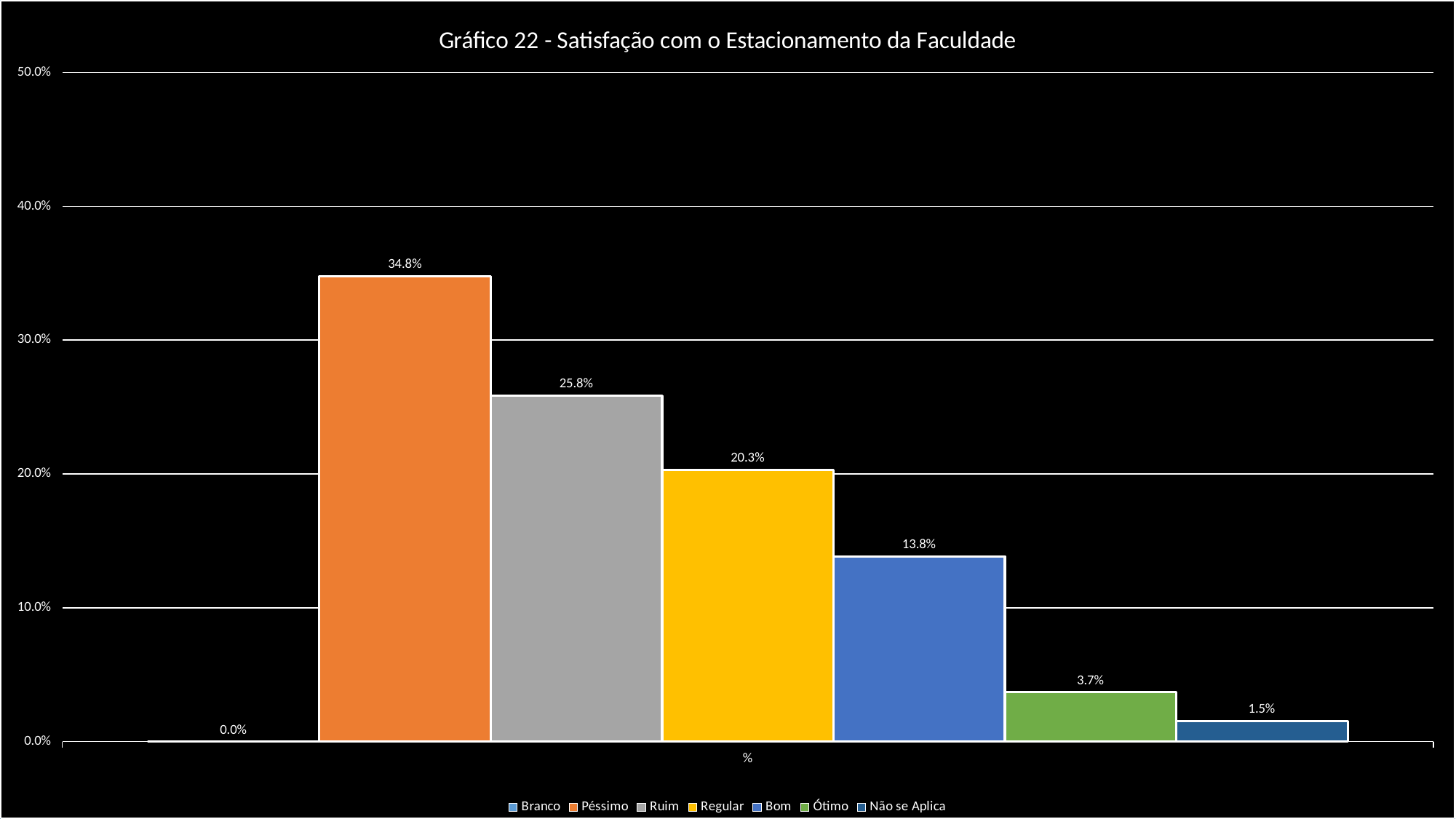
Which is larger, the value for Ótimo or the value for Não se Aplica? Ótimo What is the difference between the values for Ruim and Bom? 12.0% Which series has the lowest value? Branco How many series does the legend list? 7 What is the value for Não se Aplica? 1.5% What is the value for Péssimo? 34.8% What is the value for Regular? 20.3% Which series has the highest value? Péssimo Is the value for Ruim greater or less than 30.0%? less What colour is the bar for Regular? yellow What is the title of the chart? Gráfico 22 - Satisfação com o Estacionamento da Faculdade What kind of chart is shown? bar chart